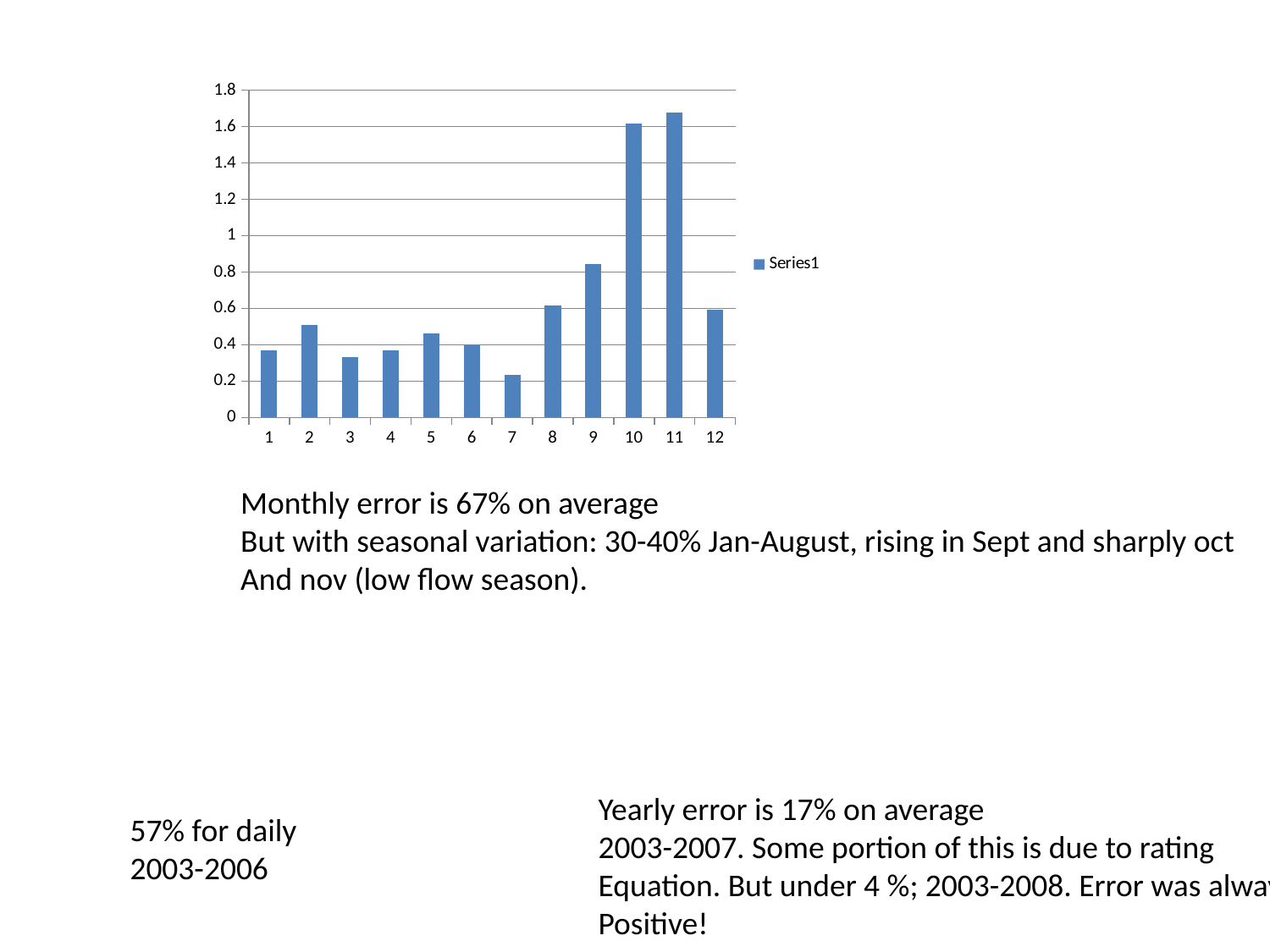
What kind of chart is shown on the slide? bar chart What is the name of the series shown in the chart's legend? Series1 Which has the larger value, category 9 or category 8? 9 Is the value for category 7 greater or less than 0.4? less How many series does the chart's legend list? 1 Is the value for category 2 greater or less than 0.4? greater Is the value for category 10 greater or less than 1.4? greater Do the values rise or fall from category 7 to category 11? rise Which category has the lowest bar in the chart? 7 How many categories are plotted along the x axis of the chart? 12 Which category has the highest bar in the chart? 11